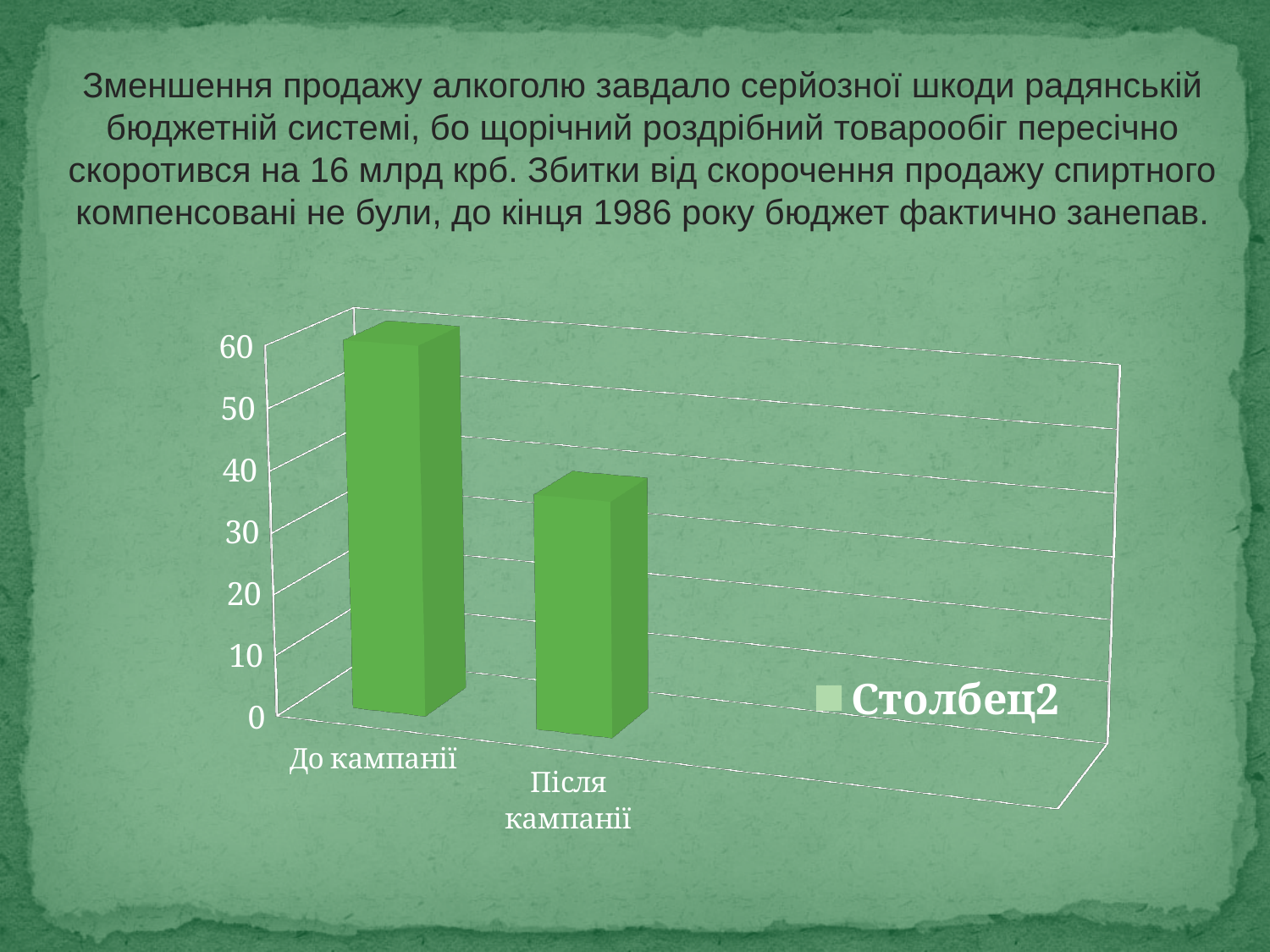
Which category has the highest bar? До кампанії Is the value for Після кампанії greater or less than 50? less Which is larger, the value for До кампанії or the value for Після кампанії? До кампанії What kind of chart is shown on the slide? bar chart What is the highest tick value shown on the vertical axis? 60 Is the value for До кампанії greater or less than 40? greater Do the values rise or fall from До кампанії to Після кампанії? fall Which category has the lowest bar? Після кампанії How many series does the chart legend list? 1 How many categories are plotted on the chart? 2 Is the value for Після кампанії greater or less than 20? greater What is the name of the series shown in the chart legend? Столбец2